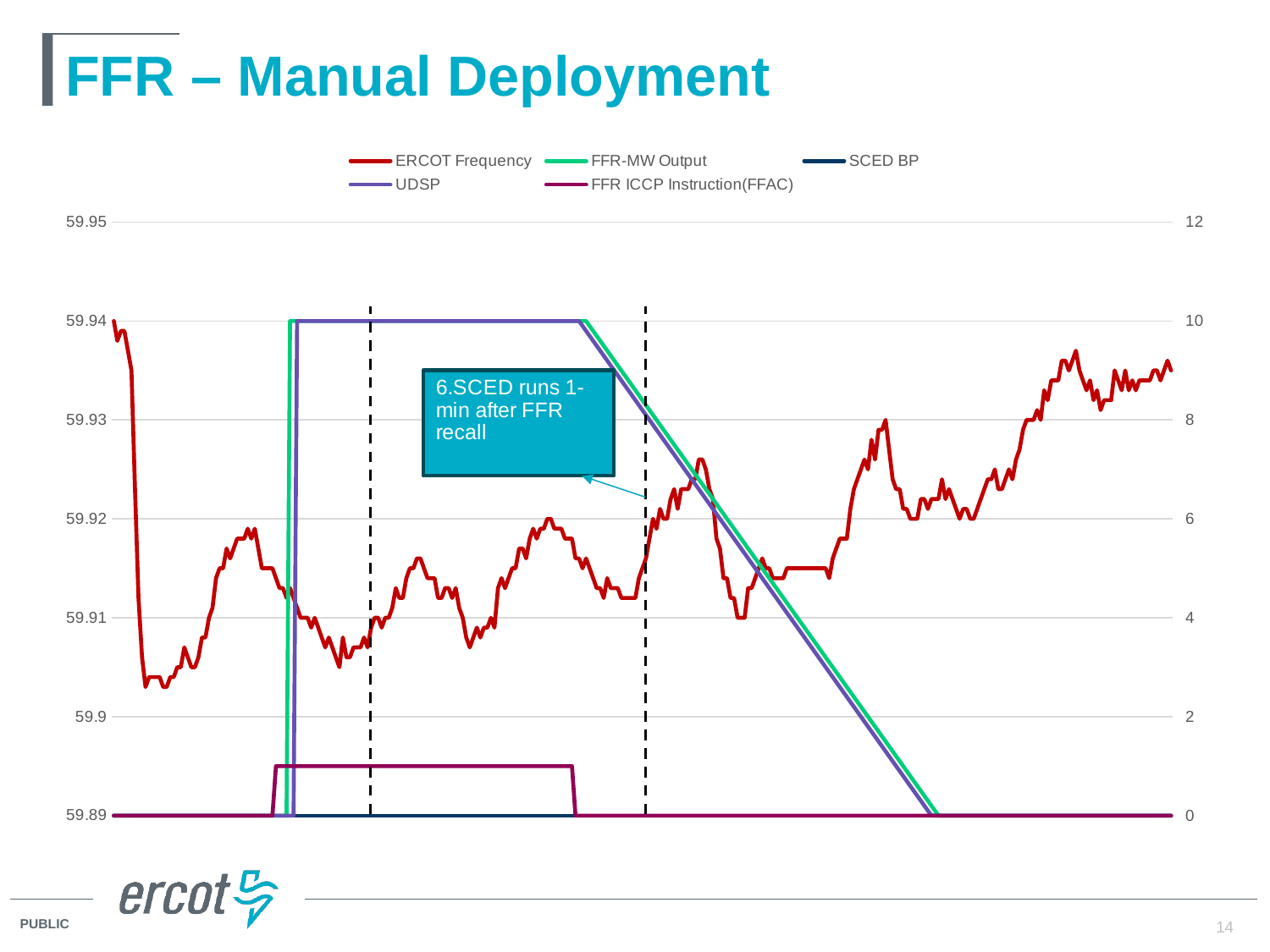
Is the plateau value of the FFR ICCP Instruction(FFAC) series greater or less than 2 on the right axis? less What is the highest value shown on the left axis? 59.95 After its plateau, does the FFR-MW Output series rise or fall along the x axis? fall What value on the right axis does the FFR-MW Output plateau reach? 10 How many series does the legend list? 5 Is the lowest value of the ERCOT Frequency series greater or less than 59.9? greater What is the title of the slide containing the chart? FFR – Manual Deployment Which series is drawn in red in the chart? ERCOT Frequency Is the lowest value of the ERCOT Frequency series greater or less than 59.91? less Which series stays at 0 on the right axis for the entire chart? SCED BP What kind of chart is shown on the slide? line chart